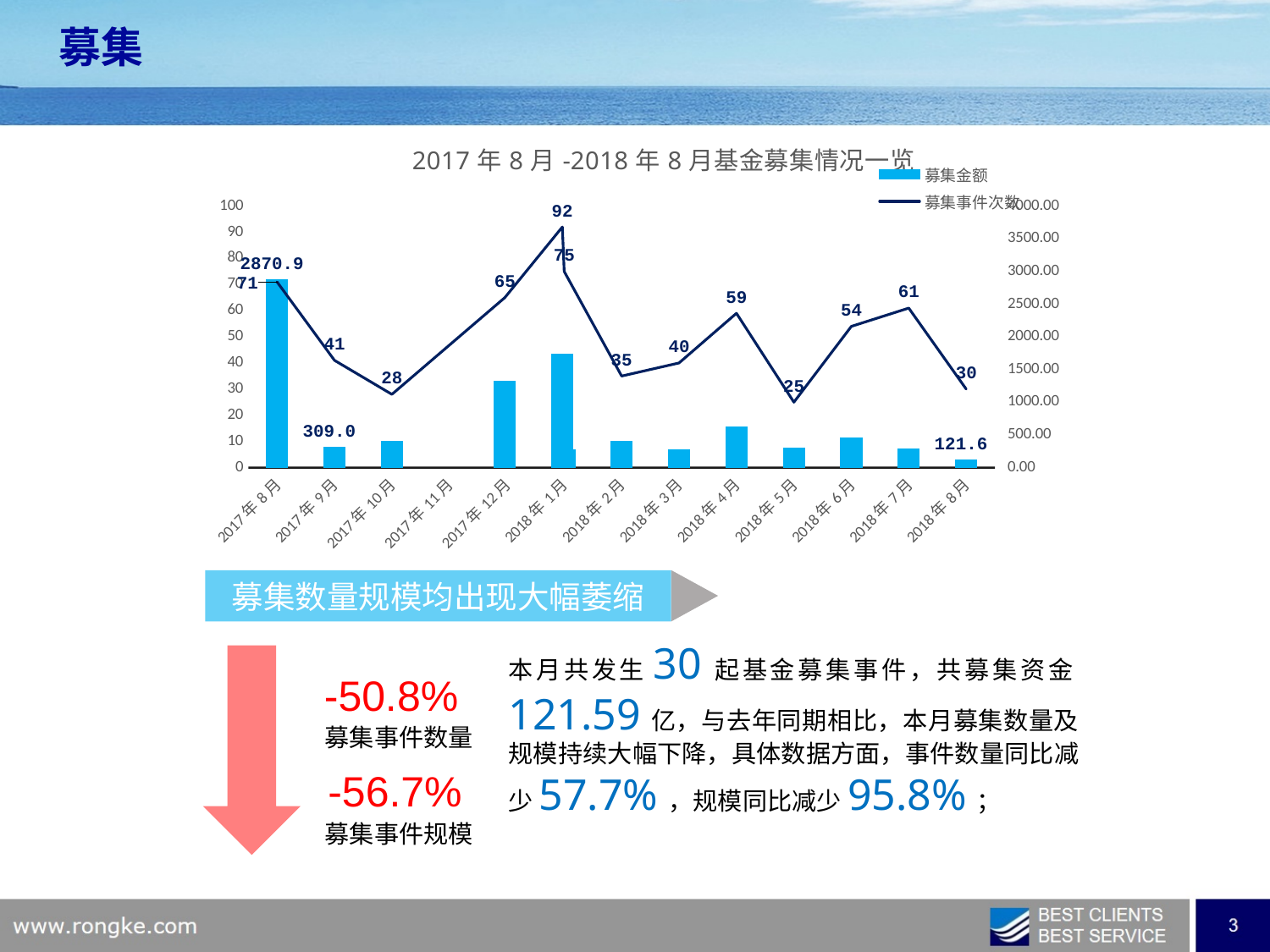
Which month has the highest 募集金额? 2017年8月 Which month has the lowest 募集事件次数? 2018年5月 What is the difference between the 募集事件次数 for 2017年8月 and 2018年8月? 41 Which is larger, the 募集金额 for 2017年9月 or for 2018年8月? 2017年9月 What is the 募集事件次数 value for 2018年7月? 61 What kind of chart is this? Combination bar and line chart What is the title of the chart? 2017年8月-2018年8月基金募集情况一览 How many months are shown on the x axis? 13 What is the 募集事件次数 value for 2017年10月? 28 How many series does the chart legend list? 2 What is the 募集金额 value for 2018年8月? 121.6 What is the 募集金额 value for 2017年8月? 2870.9